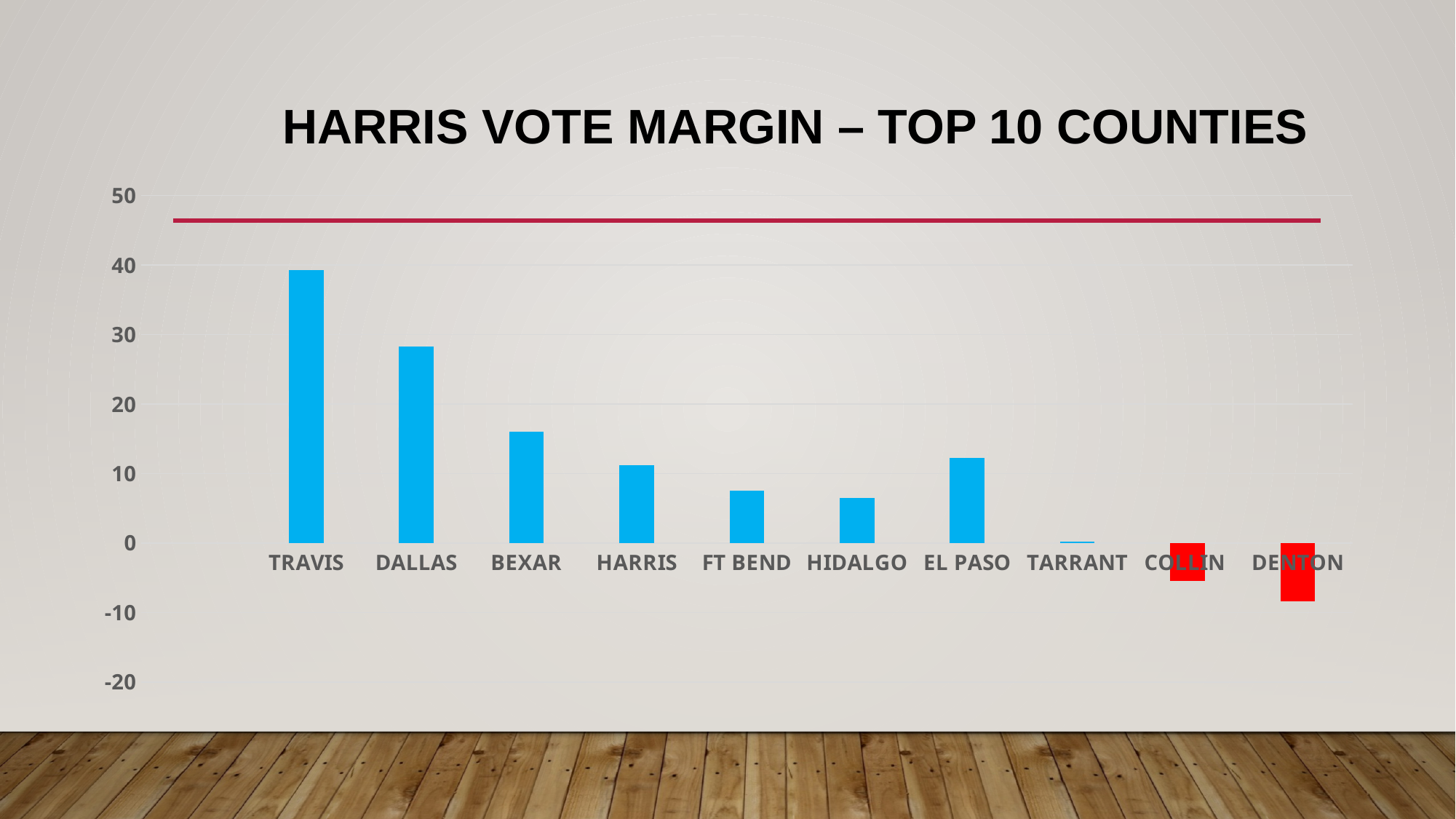
Is the value for Bexar greater or less than 20? less How many counties are shown on the x axis of the chart? 10 What is the title of the chart? Harris Vote Margin – Top 10 Counties Is the value for Travis greater or less than 30? greater Which is larger, the value for El Paso or the value for Hidalgo? El Paso Which county has the highest vote margin in the chart? Travis Which is larger, the value for Dallas or the value for Bexar? Dallas What kind of chart is shown on the slide? Bar chart Which counties are shown with red bars in the chart? Collin and Denton Is the value for Denton greater or less than 0? less Which county has the lowest vote margin in the chart? Denton